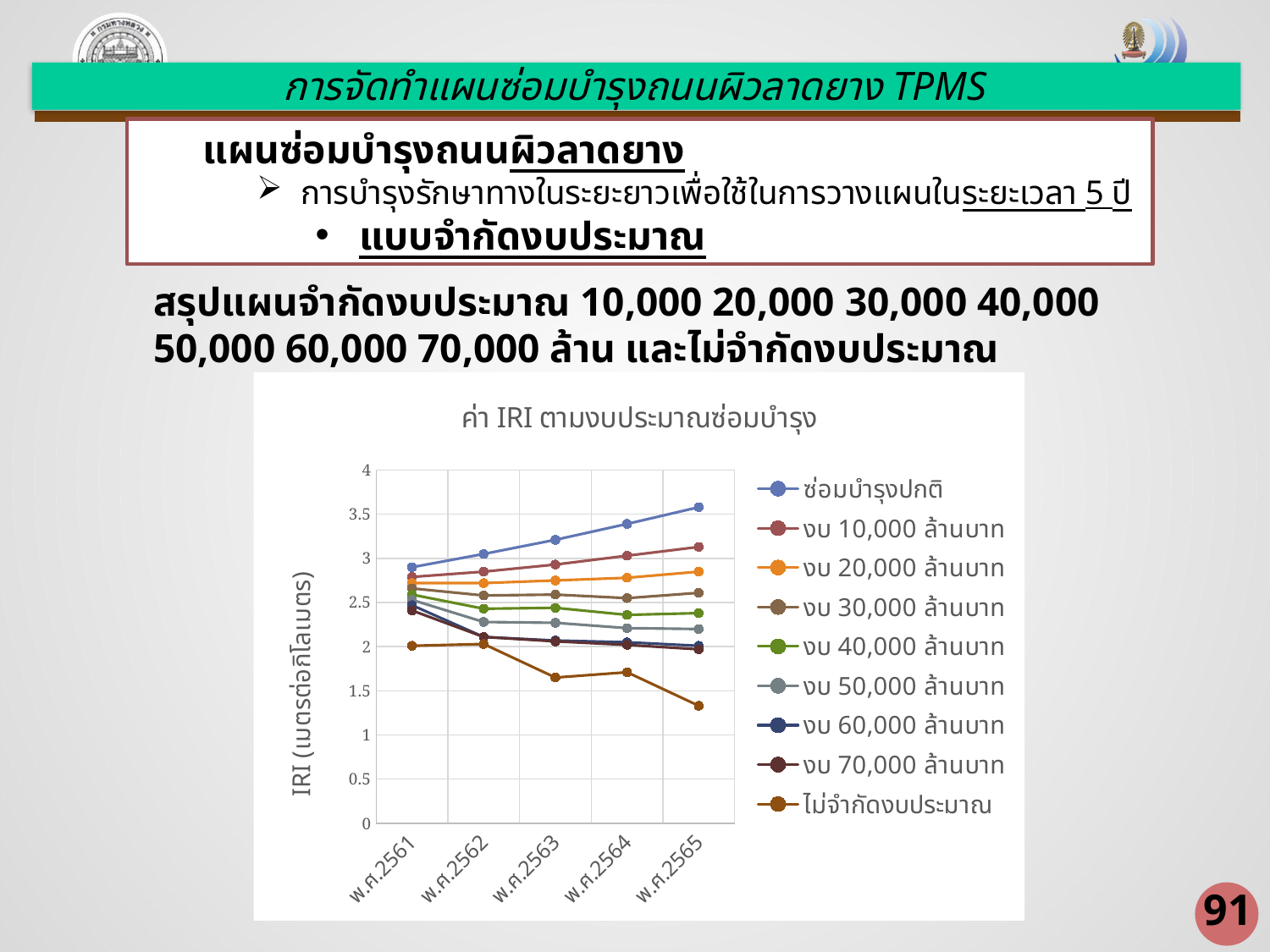
How many series does the chart legend list? 9 Does the value for ซ่อมบำรุงปกติ rise or fall from พ.ศ.2561 to พ.ศ.2565? rise Which series has the lowest IRI value at พ.ศ.2565? ไม่จำกัดงบประมาณ At พ.ศ.2564, which is larger: the value for งบ 10,000 ล้านบาท or the value for งบ 70,000 ล้านบาท? งบ 10,000 ล้านบาท Which series has the highest IRI value at พ.ศ.2565? ซ่อมบำรุงปกติ How many years are shown along the x axis of the chart? 5 Does the value for ไม่จำกัดงบประมาณ rise or fall from พ.ศ.2561 to พ.ศ.2565? fall Is the value for งบ 40,000 ล้านบาท at พ.ศ.2565 greater or less than 2.5? less What is the title of the chart? ค่า IRI ตามงบประมาณซ่อมบำรุง Is the value for ซ่อมบำรุงปกติ at พ.ศ.2565 greater or less than 3? greater What kind of chart is shown on the slide? line chart Is the value for ไม่จำกัดงบประมาณ at พ.ศ.2565 greater or less than 1.5? less